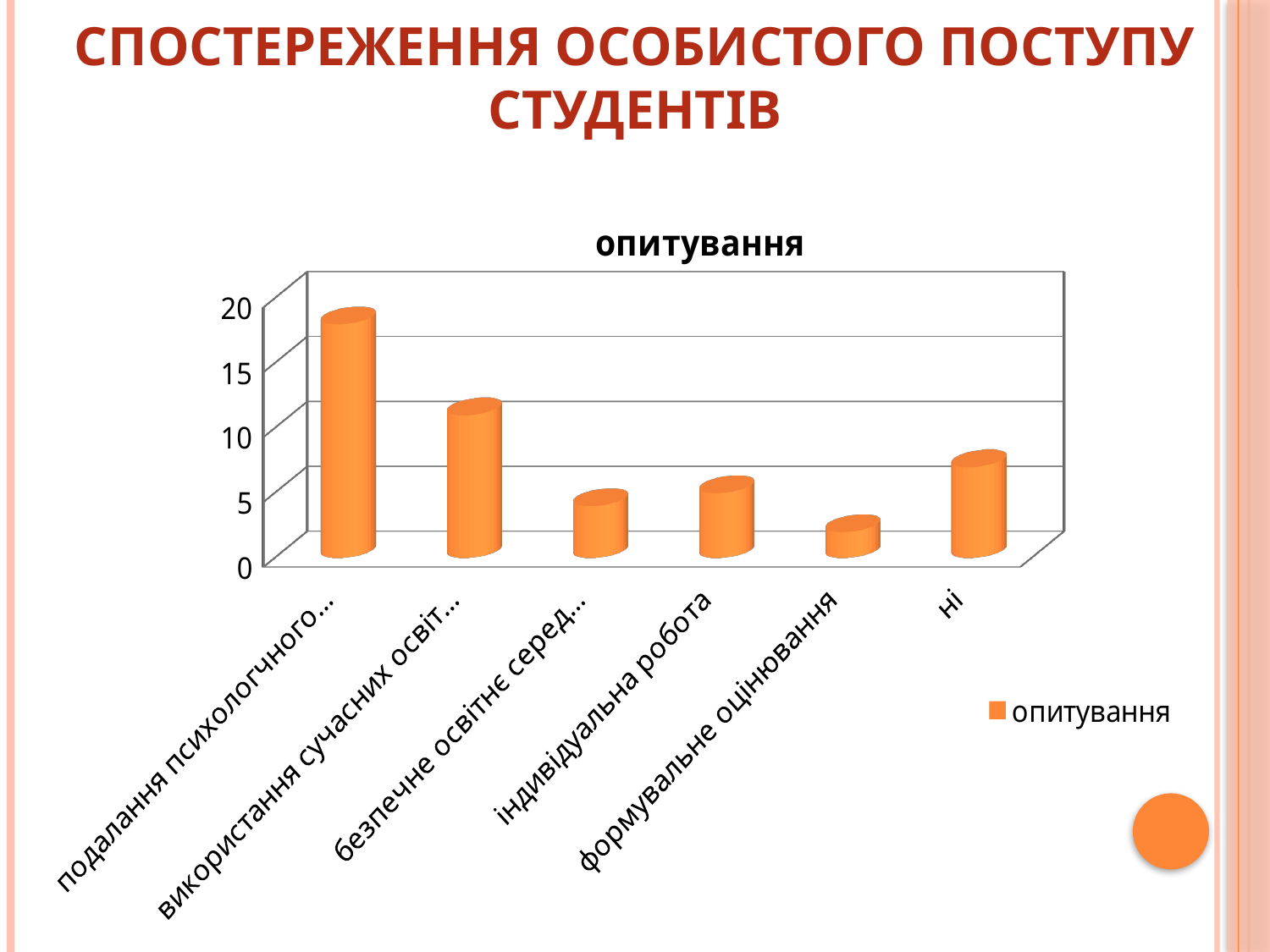
Is the value for "ні" greater or less than 5? greater Which category has the lowest value in the chart? формувальне оцінювання Which has the larger value, "ні" or "індивідуальна робота"? ні Which has the larger value, "індивідуальна робота" or "формувальне оцінювання"? індивідуальна робота How many categories are shown on the x axis of the chart? 6 Is the value for "формувальне оцінювання" greater or less than 5? less What is the name of the series listed in the legend? опитування Is the value for "індивідуальна робота" greater or less than 10? less How many series does the chart legend list? 1 What is the title of the chart? опитування What kind of chart is shown on the slide? bar chart